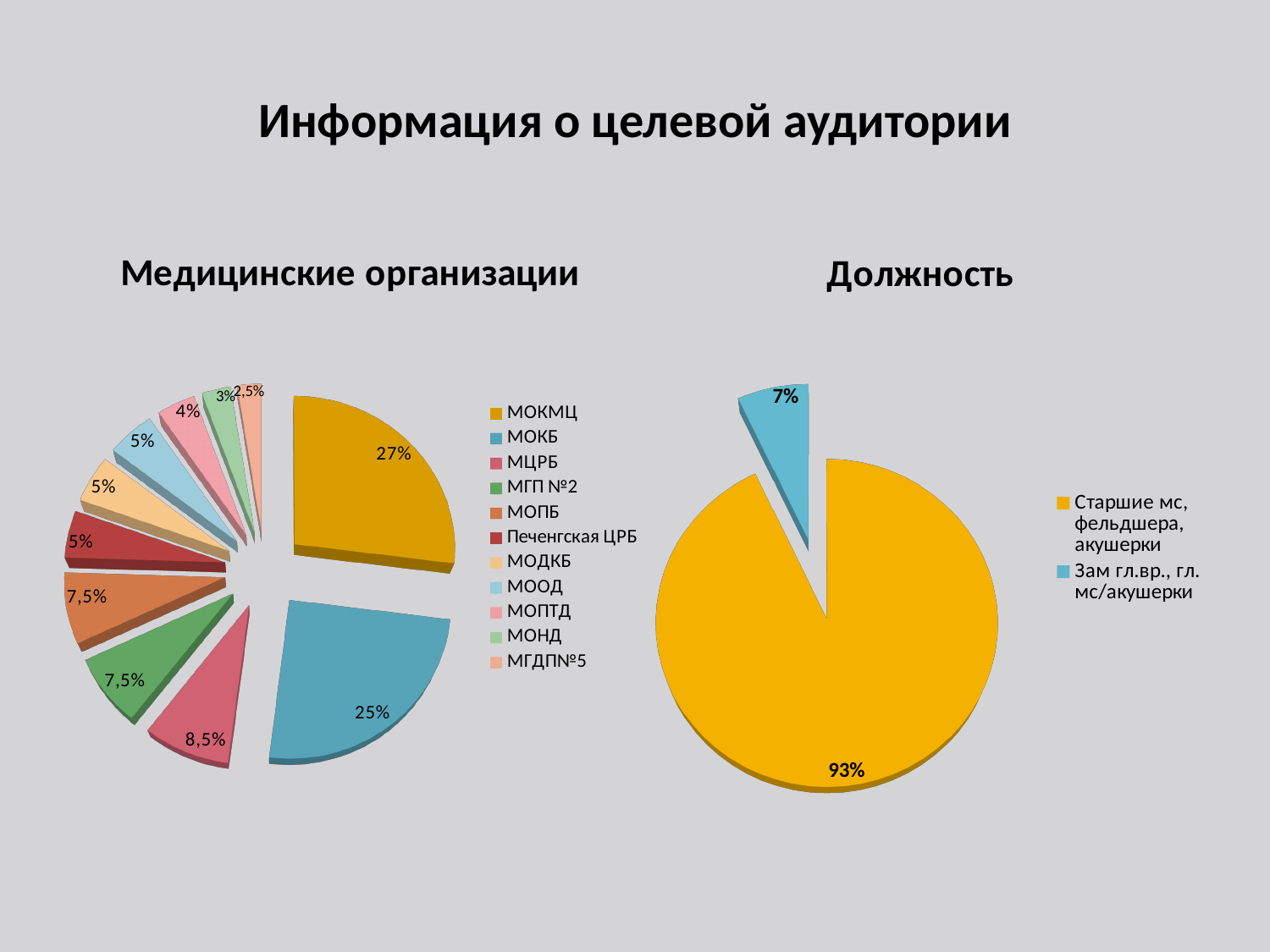
In the "Медицинские организации" chart, what share does МОКМЦ have? 27% In the "Медицинские организации" chart, how many organisations are listed in the legend? 11 In the "Медицинские организации" chart, what share does МОКБ have? 25% In the "Медицинские организации" chart, what share does МЦРБ have? 8,5% What type of chart is the "Медицинские организации" chart? pie chart In the "Медицинские организации" chart, what is the difference between the shares of МОКМЦ and МОКБ? 2% In the "Медицинские организации" chart, which organisation has the largest share? МОКМЦ In the "Медицинские организации" chart, which organisation has the smallest share? МГДП№5 In the "Медицинские организации" chart, which is larger, the share of МЦРБ or the share of МОПТД? МЦРБ In the "Должность" chart, how many categories does the legend list? 2